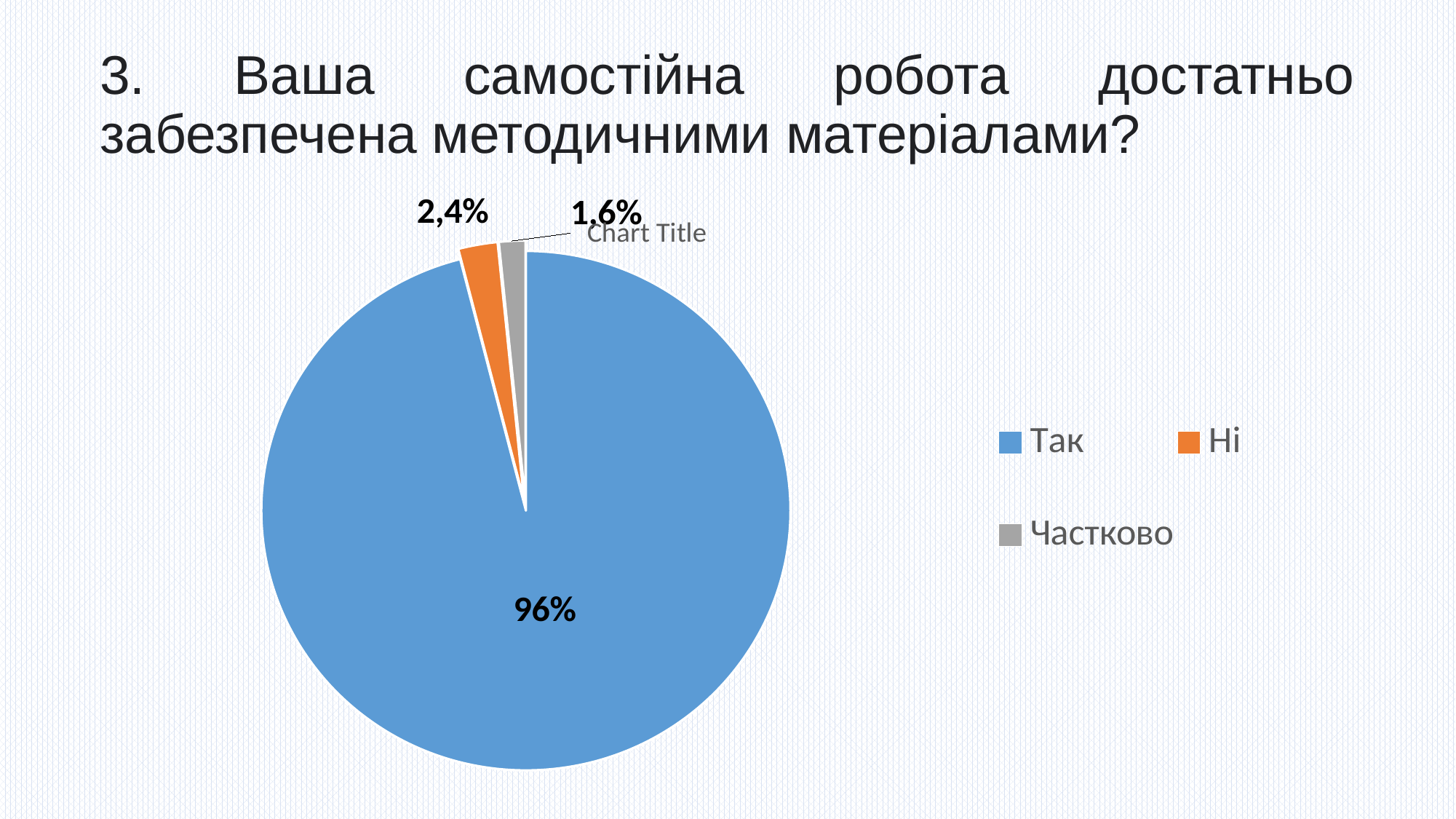
Which category has the largest slice of the pie? Так What kind of chart is shown on the slide? pie chart What title is printed on the chart itself? Chart Title What is the difference between the shares of "Ні" and "Частково"? 0,8% How many entries does the legend list? 3 What colour is the slice for "Ні"? orange What share of the pie does "Ні" have? 2,4% How many slices does the pie chart have? 3 Which slice is larger, "Ні" or "Частково"? Ні Which category has the smallest slice of the pie? Частково What share of the pie does "Частково" have? 1,6% What share of the pie does "Так" have? 96%